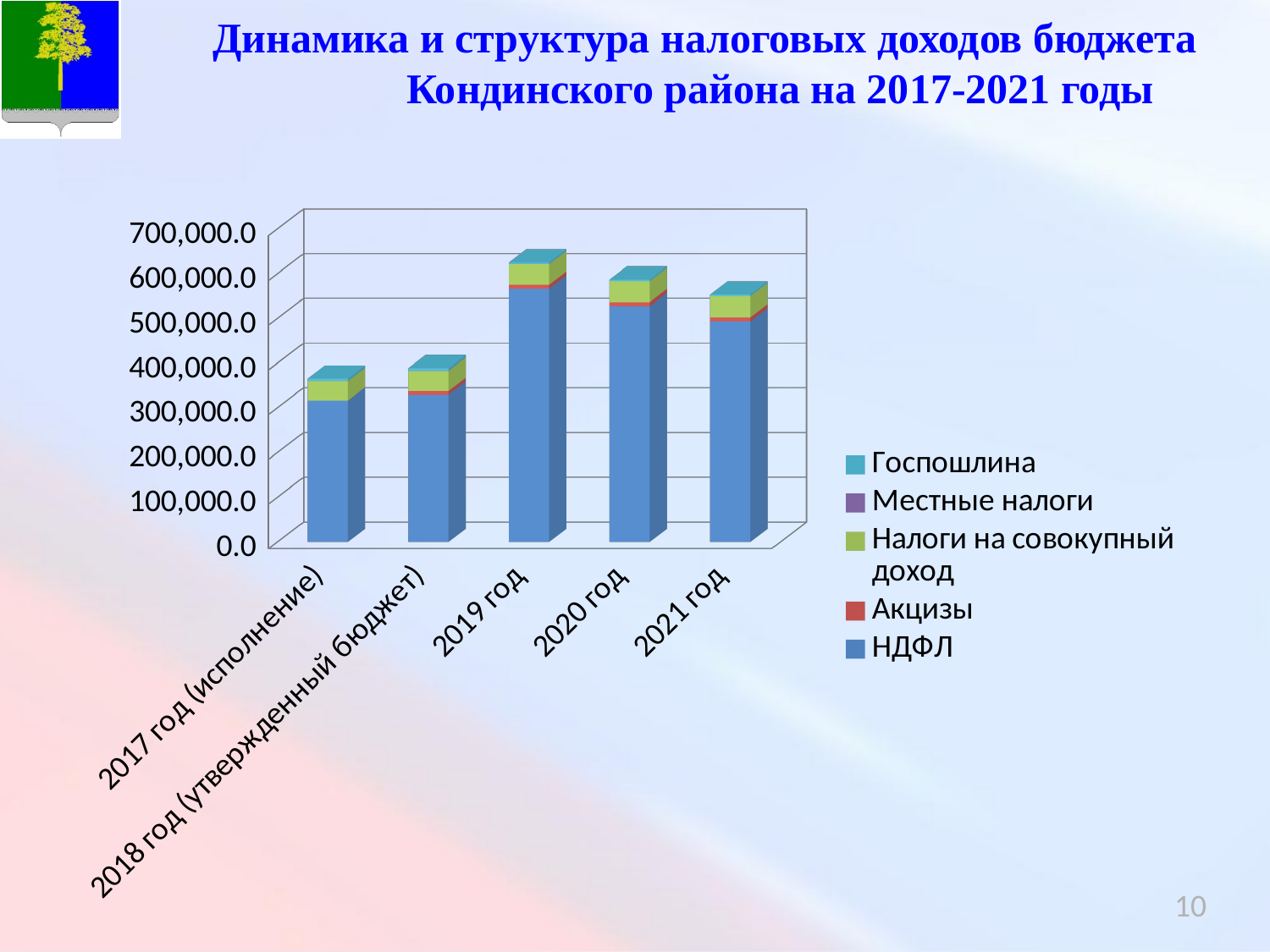
What kind of chart is shown on the slide? stacked bar chart Which series forms the largest part of each bar? НДФЛ Which total is larger, 2017 год (исполнение) or 2019 год? 2019 год Is the total for 2021 год greater or less than 500,000.0? greater Is the total for 2019 год greater or less than 500,000.0? greater Do the total bars rise or fall from 2019 год to 2021 год? fall How many series does the legend list? 5 Is the total for 2017 год (исполнение) greater or less than 400,000.0? less Which category has the lowest total bar? 2017 год (исполнение) Which total is larger, 2019 год or 2020 год? 2019 год How many categories (years) are plotted along the x axis? 5 Which year has the highest total bar? 2019 год